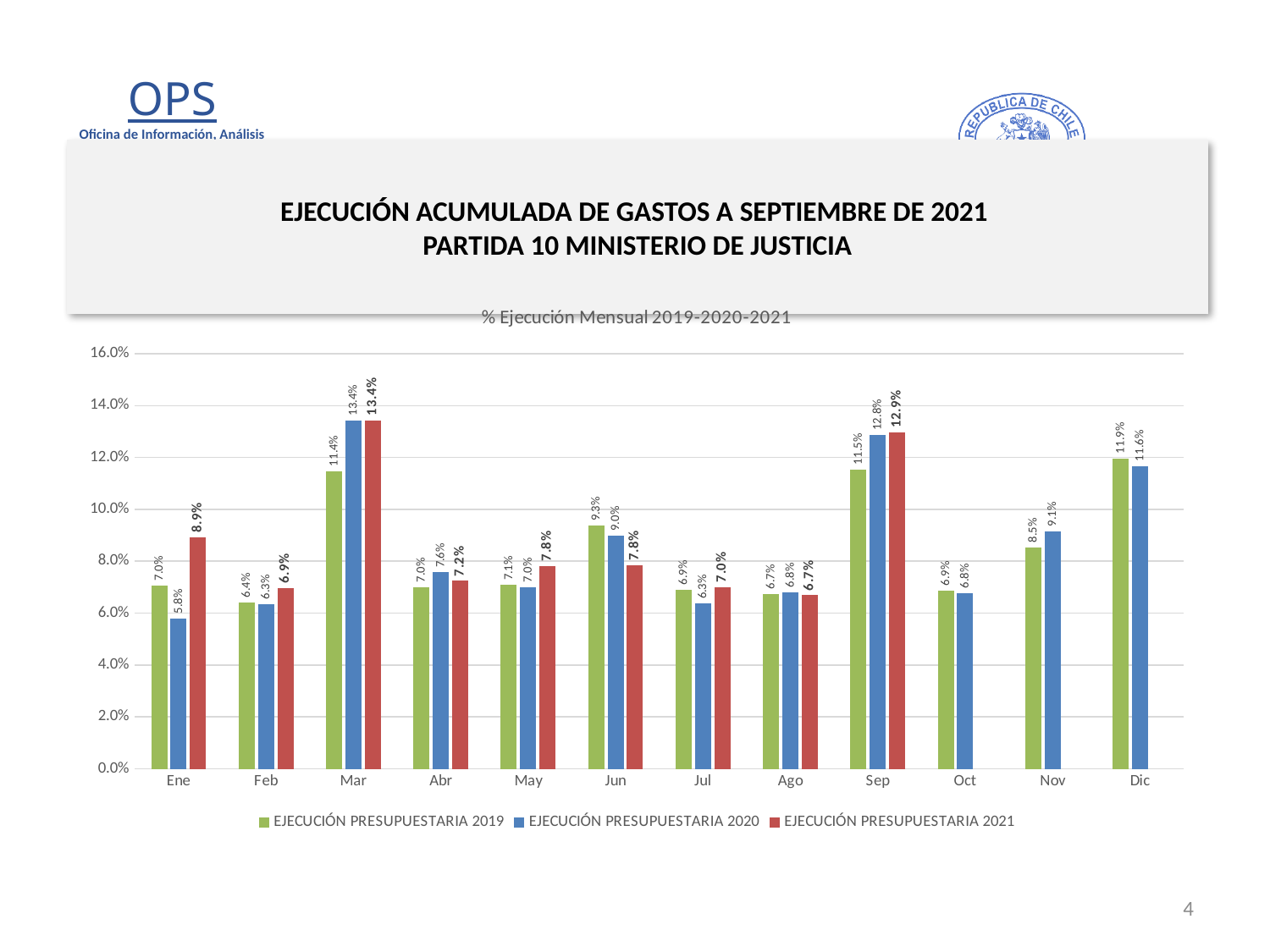
In which month is the EJECUCIÓN PRESUPUESTARIA 2020 value lowest? Ene How many series does the legend list? 3 How many months are shown on the x axis? 12 What is the value for EJECUCIÓN PRESUPUESTARIA 2020 in Sep? 12.8% In which month is the EJECUCIÓN PRESUPUESTARIA 2021 value highest? Mar What is the title of the chart? % Ejecución Mensual 2019-2020-2021 What kind of chart is shown on the slide? Bar chart What is the difference between the EJECUCIÓN PRESUPUESTARIA 2020 and EJECUCIÓN PRESUPUESTARIA 2019 values in Mar? 2.0% Is the value for EJECUCIÓN PRESUPUESTARIA 2019 in Sep greater or less than 10.0%? greater Which is larger in Jun: the EJECUCIÓN PRESUPUESTARIA 2019 value or the EJECUCIÓN PRESUPUESTARIA 2021 value? EJECUCIÓN PRESUPUESTARIA 2019 What is the value for EJECUCIÓN PRESUPUESTARIA 2019 in Dic? 11.9% What is the value for EJECUCIÓN PRESUPUESTARIA 2021 in Ene? 8.9%